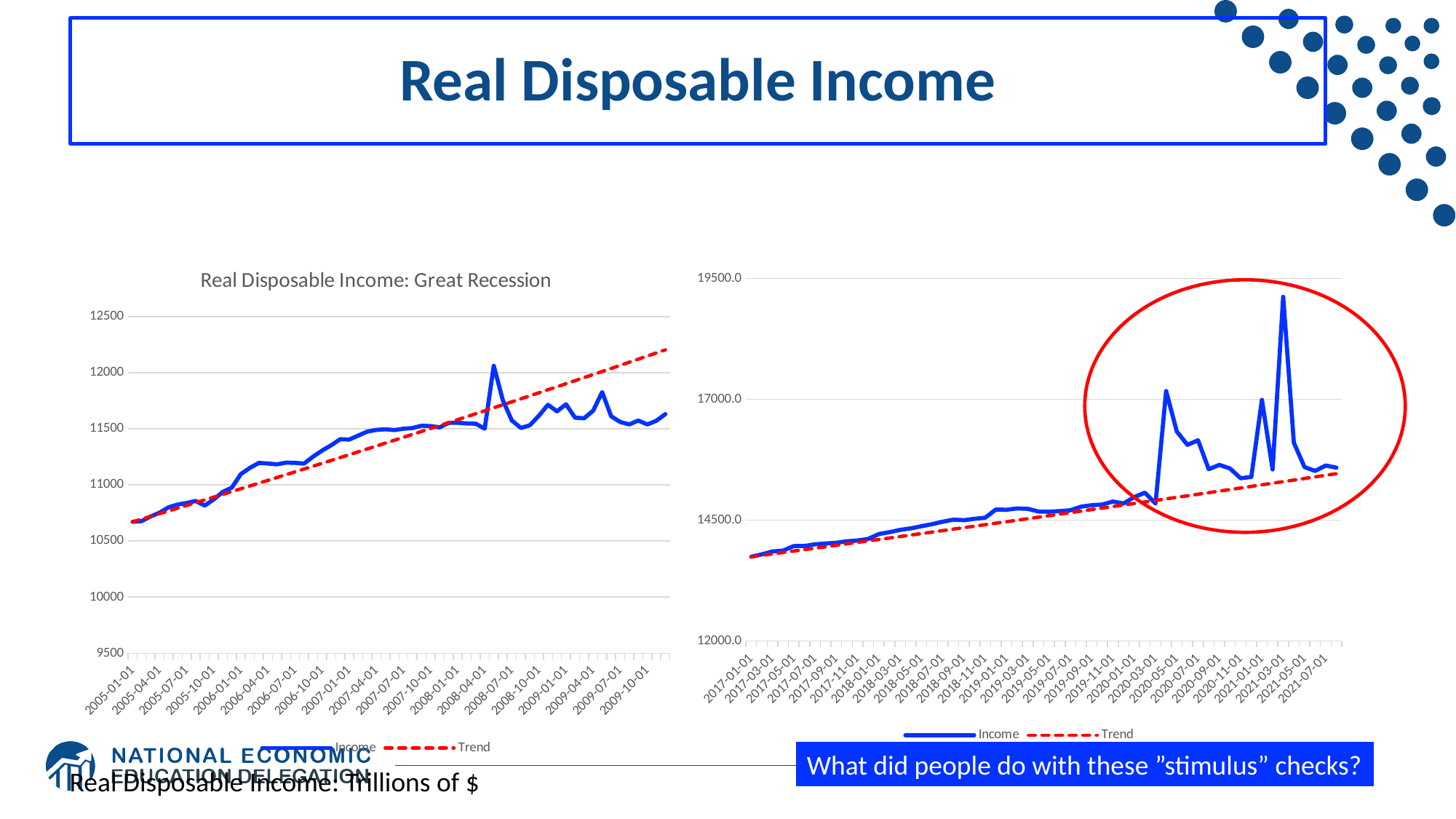
In the right chart, is the Income value at 2017-01-01 greater or less than 14500.0? less In the left chart, is the highest Income value (the spike in mid-2008) greater or less than 12000? greater In the left chart, is the Income value at 2005-01-01 greater or less than 11000? less How many series does the legend of the right chart list? 2 What type of chart is the left chart titled "Real Disposable Income: Great Recession"? line chart What type of chart is the right chart on the slide? line chart In the right chart, does the Trend line rise or fall from 2017-01-01 to 2021-07-01? rise What are the two series named in the legend of the left chart? Income and Trend